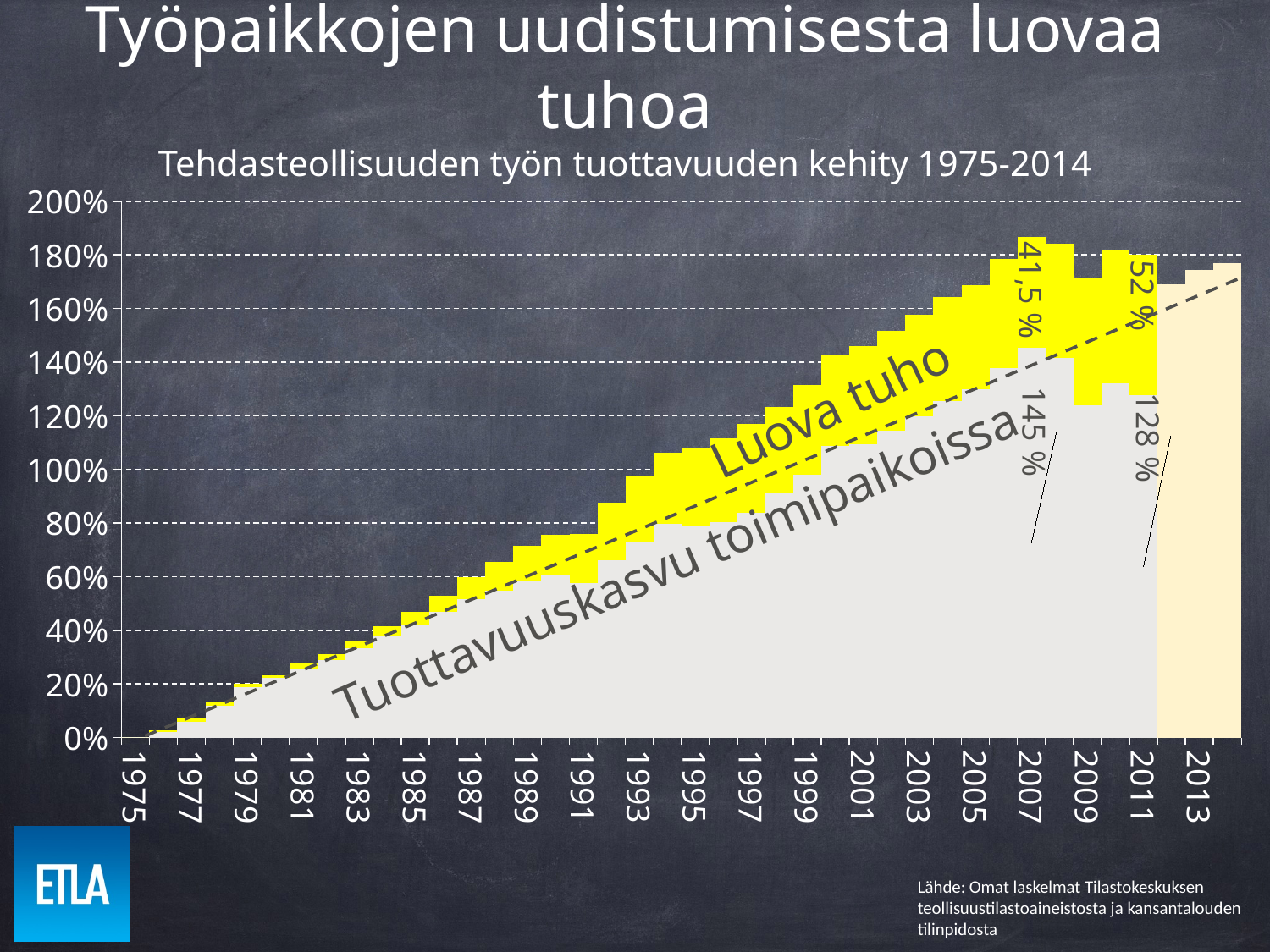
Which labelled value is larger around 2011: Luova tuho or Tuottavuuskasvu toimipaikoissa? Tuottavuuskasvu toimipaikoissa Is the total value for 1985 greater or less than 60%? less What kind of chart is shown on the slide? Stacked bar chart What value is labelled for Luova tuho (the yellow area) around 2007? 41,5 % What does the yellow area of the chart represent? Luova tuho Is the total value for 2013 greater or less than 160%? greater What value is labelled for Tuottavuuskasvu toimipaikoissa (the grey area) around 2007? 145 % Does the total productivity index generally rise or fall from 1975 to 2014? Rise What value is labelled for Luova tuho (the yellow area) around 2011? 52 % What is the difference between the labelled values 145 % and 41,5 % around 2007? 103,5 % What value is labelled for Tuottavuuskasvu toimipaikoissa (the grey area) around 2011? 128 % What is the title of the chart? Tehdasteollisuuden työn tuottavuuden kehity 1975-2014